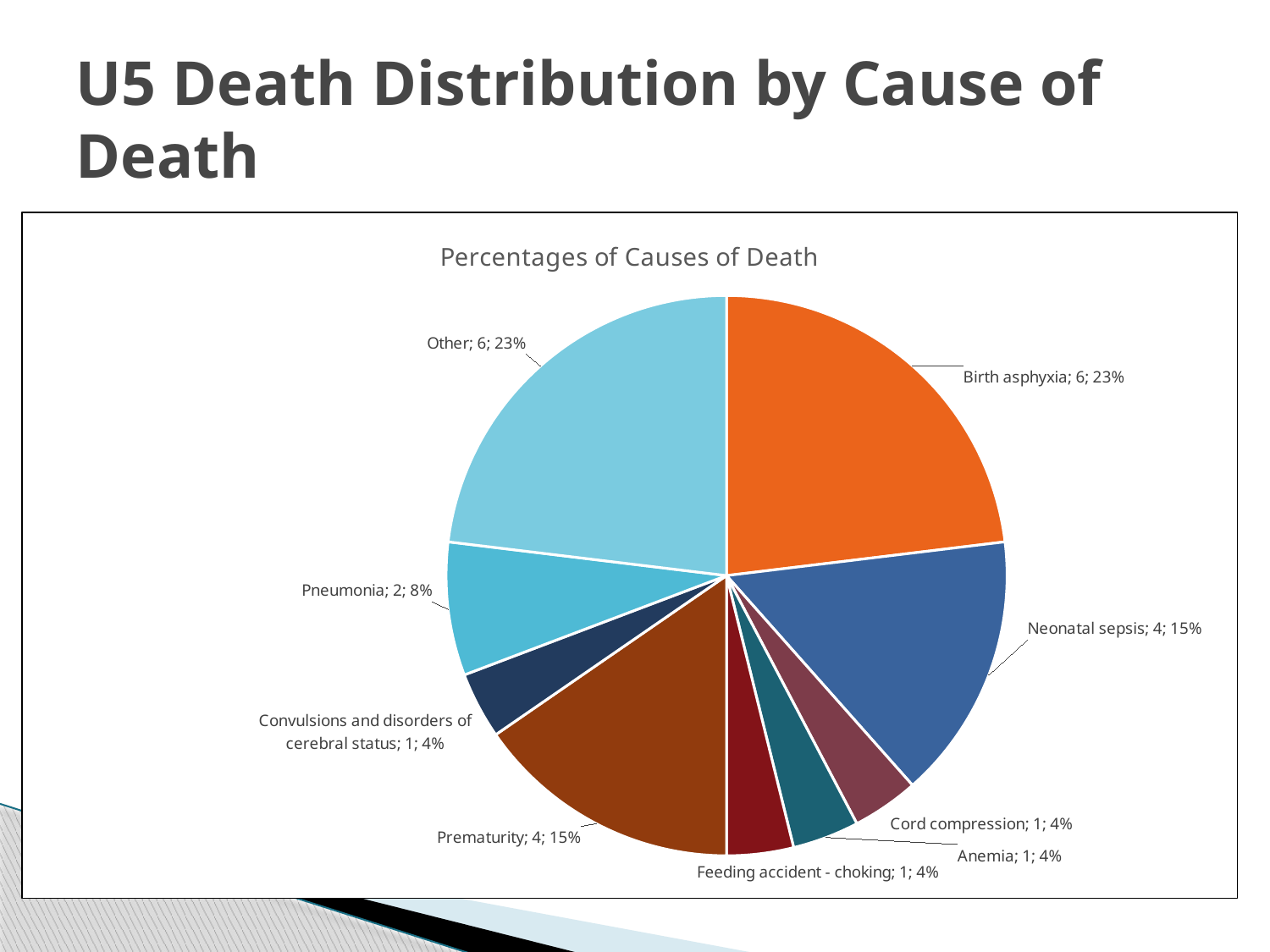
How many deaths are attributed to Pneumonia? 2 What percentage of deaths is attributed to Cord compression? 4% What is the title of the chart? Percentages of Causes of Death What is the difference in percentage points between the Other slice and the Convulsions and disorders of cerebral status slice? 19 What percentage of deaths is attributed to Prematurity? 15% Which accounts for more deaths, Neonatal sepsis or Pneumonia? Neonatal sepsis What percentage of deaths is attributed to Birth asphyxia? 23% How many deaths are attributed to Neonatal sepsis? 4 How many deaths are in the Other category? 6 What type of chart is shown on the slide? pie chart How many more deaths are attributed to Birth asphyxia than to Pneumonia? 4 How many slices (causes of death) does the pie chart show? 9